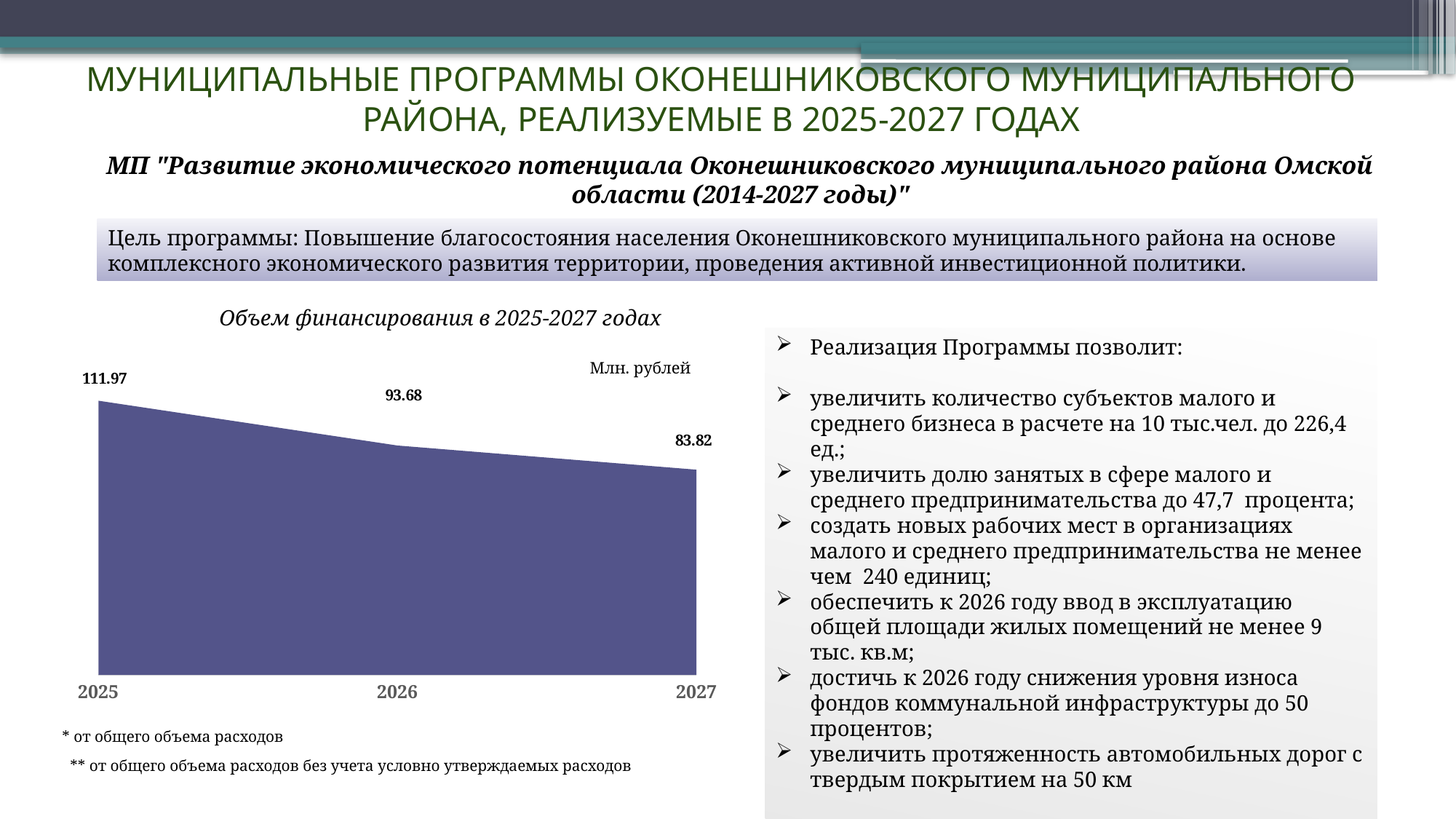
What is the value for 2027 in the chart "Объем финансирования в 2025-2027 годах"? 83.82 Do the values in the chart "Объем финансирования в 2025-2027 годах" rise or fall from 2025 to 2027? fall How many years are plotted in the chart "Объем финансирования в 2025-2027 годах"? 3 In the chart "Объем финансирования в 2025-2027 годах", which is larger: the value for 2025 or the value for 2027? 2025 What is the difference between the 2026 and 2027 values in the chart "Объем финансирования в 2025-2027 годах"? 9.86 What unit is shown for the values in the chart "Объем финансирования в 2025-2027 годах"? Млн. рублей What kind of chart is "Объем финансирования в 2025-2027 годах"? area chart What is the difference between the 2025 and 2026 values in the chart "Объем финансирования в 2025-2027 годах"? 18.29 What is the value for 2026 in the chart "Объем финансирования в 2025-2027 годах"? 93.68 What is the value for 2025 in the chart "Объем финансирования в 2025-2027 годах"? 111.97 Which year has the highest value in the chart "Объем финансирования в 2025-2027 годах"? 2025 Which year has the lowest value in the chart "Объем финансирования в 2025-2027 годах"? 2027